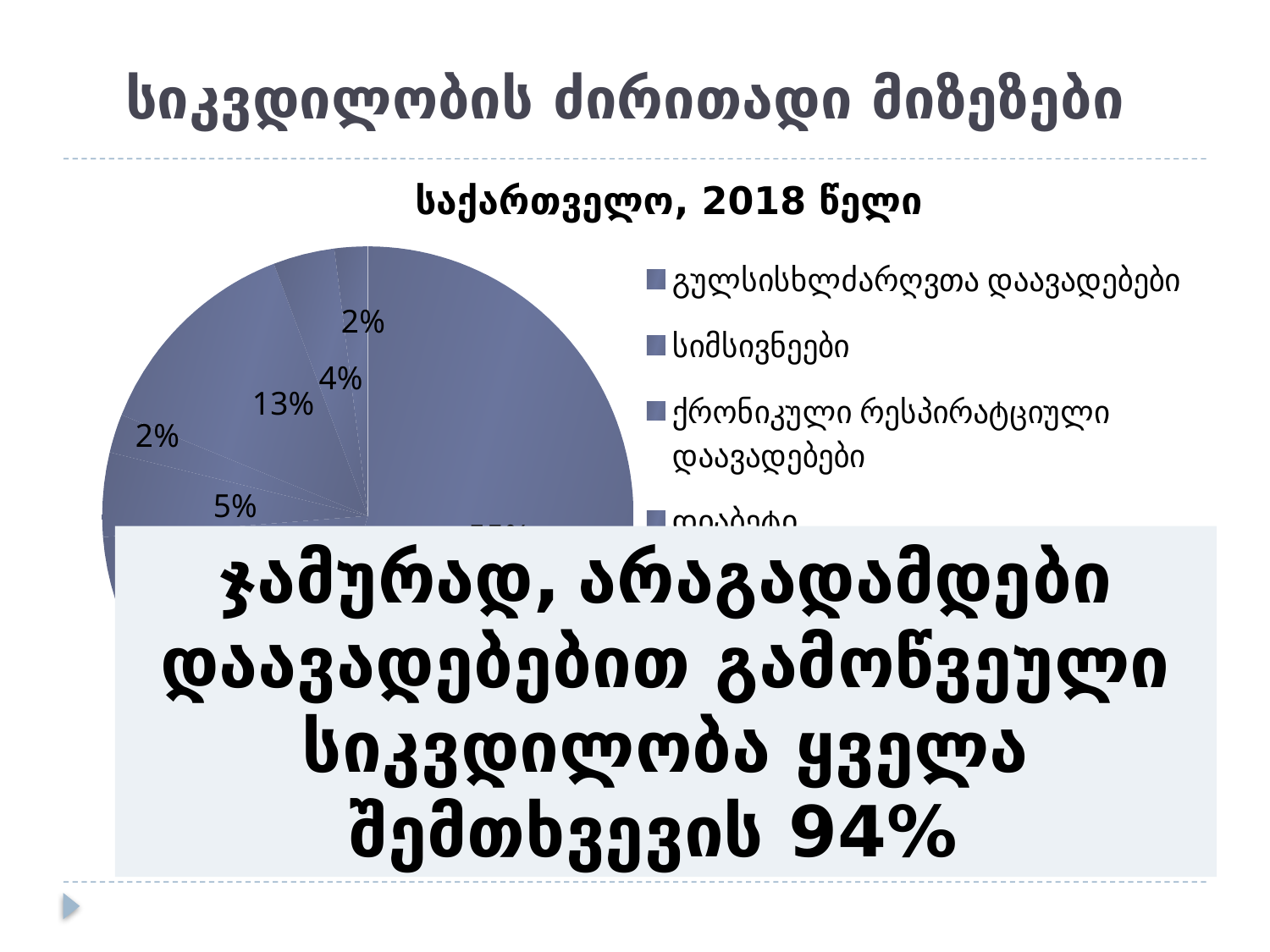
What kind of chart is shown on the slide? pie chart What is the first entry listed in the pie chart's legend? გულსისხლძარღვთა დაავადებები Which category has the largest slice of the pie chart? გულსისხლძარღვთა დაავადებები What is the title of the pie chart? საქართველო, 2018 წელი Is the share of the largest slice (გულსისხლძარღვთა დაავადებები) greater or less than 50%? greater What is the largest percentage printed on the small slices on the left side of the pie chart? 13%